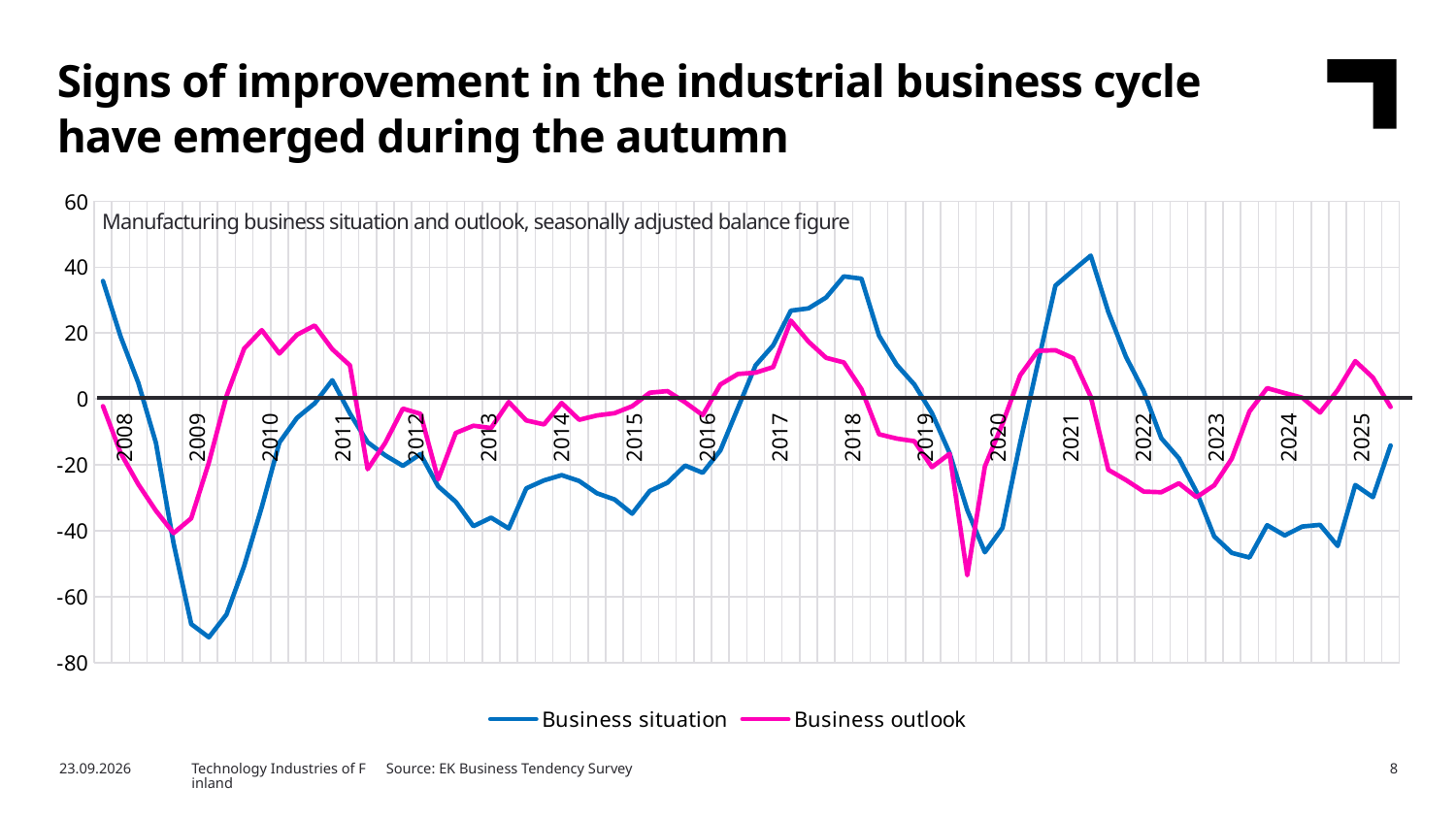
Is the Business situation value at the start of 2008 greater or less than 20? greater Is the lowest value of the Business situation series, reached in 2009, greater or less than -60? less Does the Business situation series rise or fall between 2008 and 2009? Fall What kind of chart is shown on the slide? Line chart At the 2009 trough, which series has the lower value, Business situation or Business outlook? Business situation How many series does the legend list? 2 Does the Business situation series rise or fall between its 2021 peak and 2023? Fall What are the two series named in the legend? Business situation and Business outlook What is the title printed inside the chart area? Manufacturing business situation and outlook, seasonally adjusted balance figure Is the peak value of the Business situation series in 2021 greater or less than 40? greater At the 2020 trough, which series has the lower value, Business situation or Business outlook? Business outlook